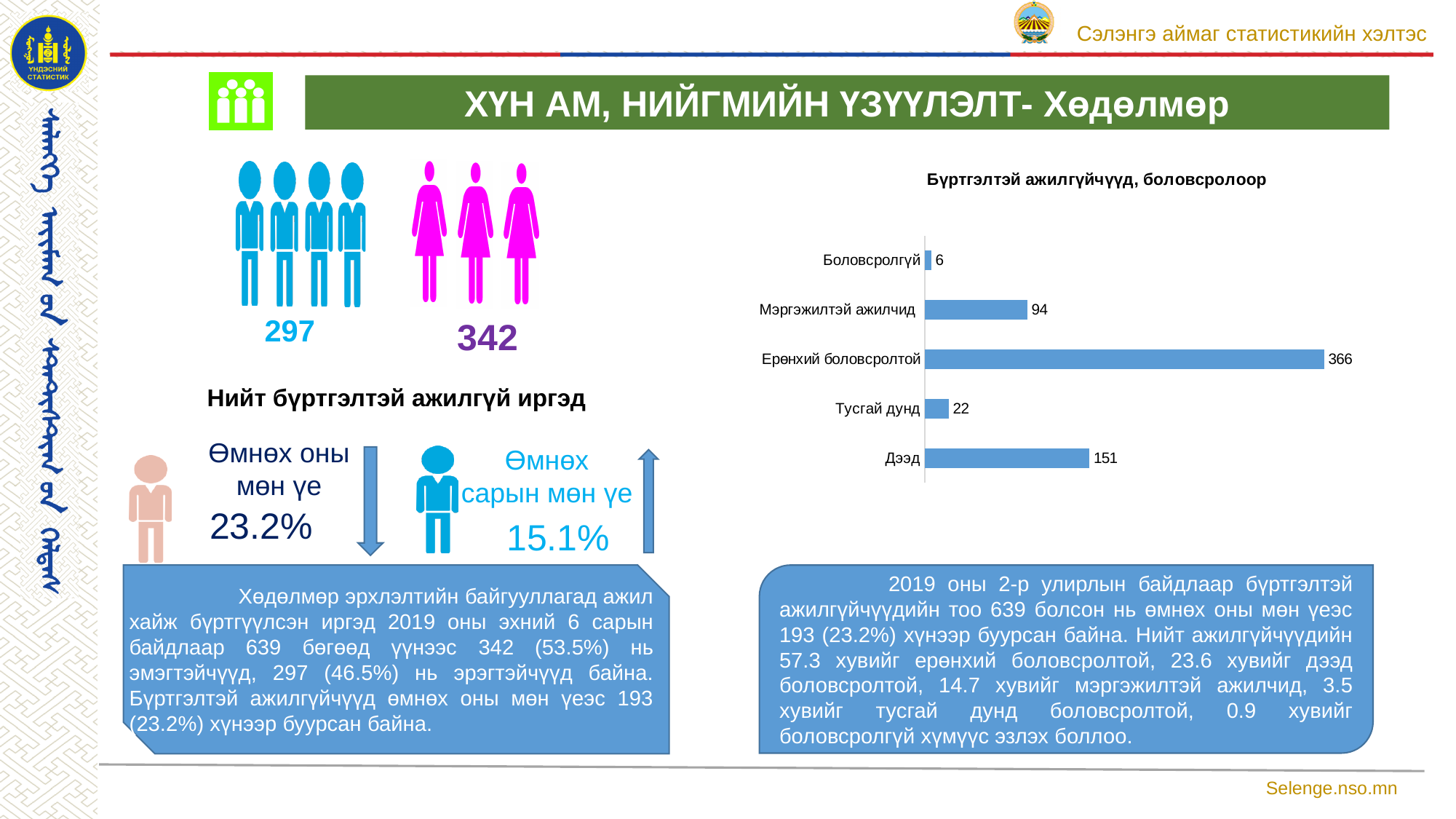
How many categories are shown in the chart? 5 What is the value for "Тусгай дунд" in the chart? 22 What is the difference between the values for "Ерөнхий боловсролтой" and "Дээд"? 215 What is the value for "Дээд" in the chart? 151 What is the title of the bar chart on the slide? Бүртгэлтэй ажилгүйчүүд, боловсролоор What type of chart is shown under the title "Бүртгэлтэй ажилгүйчүүд, боловсролоор"? Bar chart What is the value for "Боловсролгүй" in the chart? 6 Which category has the lowest value in the chart? Боловсролгүй Which is larger in the chart: "Мэргэжилтэй ажилчид" or "Тусгай дунд"? Мэргэжилтэй ажилчид Which category has the highest value in the chart? Ерөнхий боловсролтой What is the value for "Ерөнхий боловсролтой" in the chart? 366 What is the value for "Мэргэжилтэй ажилчид" in the chart? 94